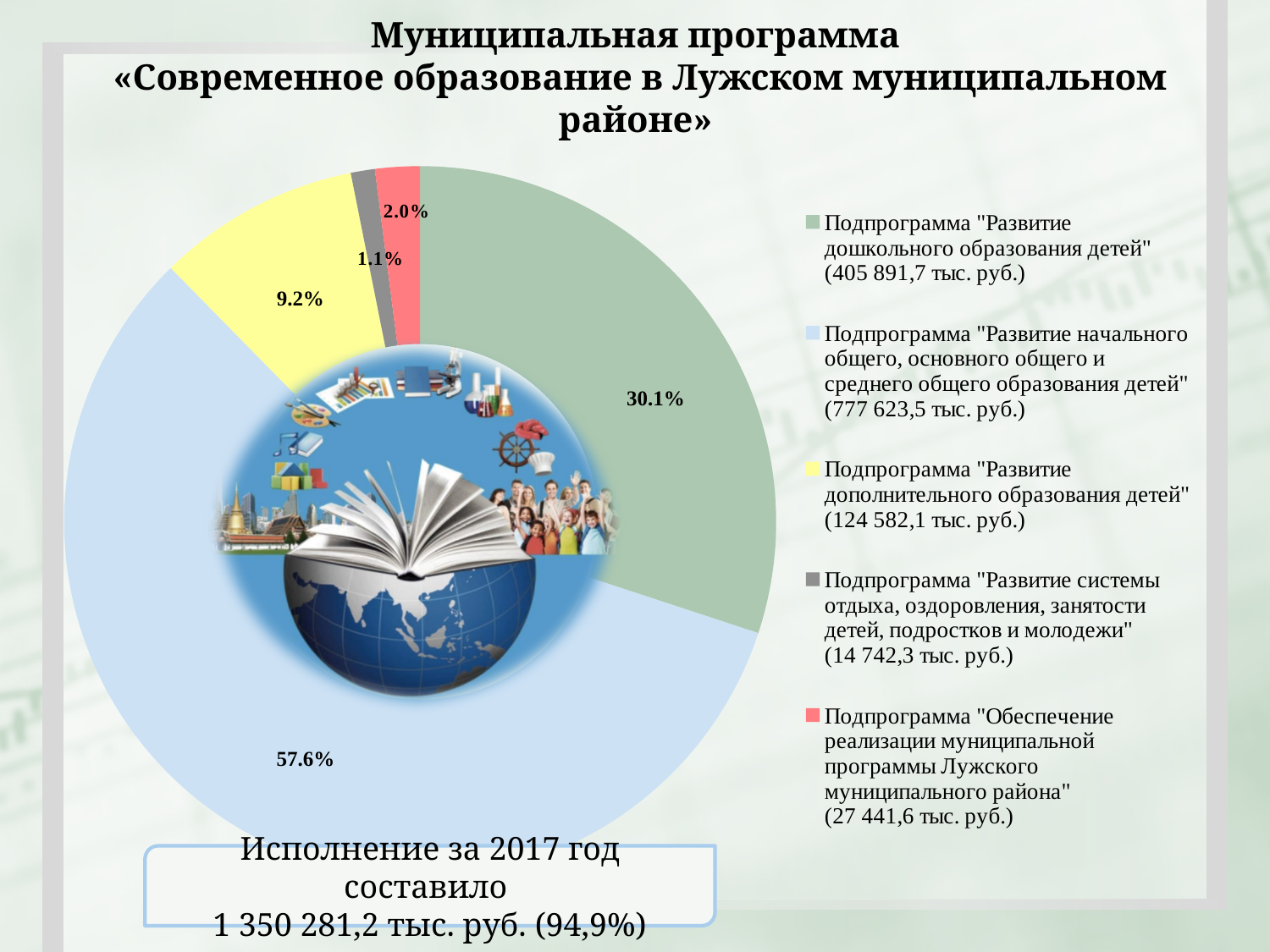
What is the difference in percentage points between the 57.6% slice and the 30.1% slice? 27.5 How many entries does the legend list? 5 Which subprogram has the largest slice of the pie? Подпрограмма "Развитие начального общего, основного общего и среднего общего образования детей" What share of the pie does the subprogram "Развитие начального общего, основного общего и среднего общего образования детей" take? 57.6% What share of the pie does the subprogram "Обеспечение реализации муниципальной программы Лужского муниципального района" take? 2.0% What kind of chart is shown on the slide? pie chart What share of the pie does the subprogram "Развитие дополнительного образования детей" take? 9.2% How many slices does the pie chart have? 5 What amount in thousand rubles does the legend give for the subprogram "Развитие дополнительного образования детей"? 124 582,1 тыс. руб. Which subprogram has the smallest slice of the pie? Подпрограмма "Развитие системы отдыха, оздоровления, занятости детей, подростков и молодежи"